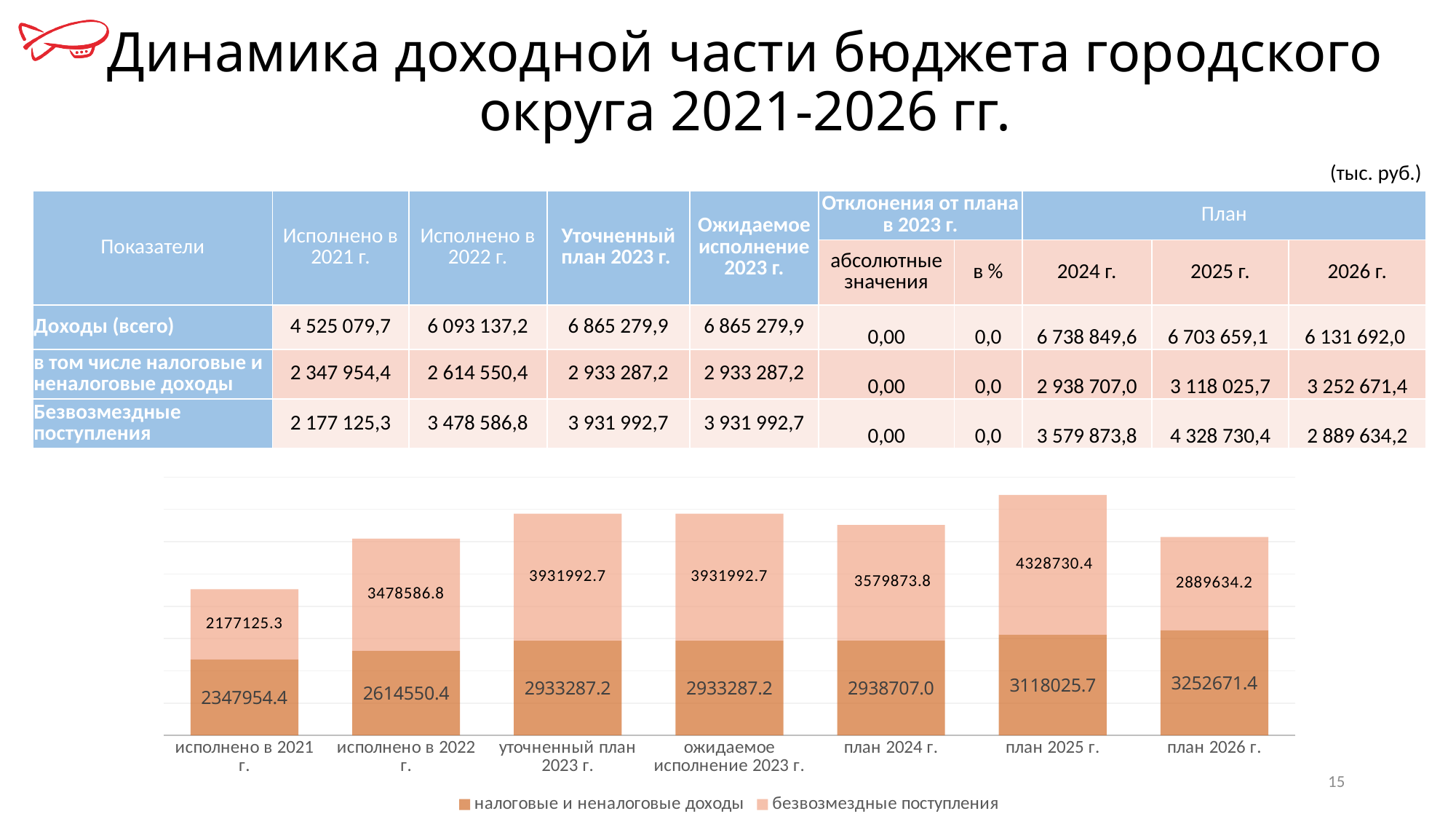
How many series does the chart legend list? 2 What is the value of налоговые и неналоговые доходы for план 2026 г. in the chart? 3252671.4 What is the difference between налоговые и неналоговые доходы for план 2026 г. and for исполнено в 2021 г. in the chart? 904717.0 Which is larger in the chart: безвозмездные поступления for план 2025 г. or for план 2026 г.? план 2025 г. What is the difference between безвозмездные поступления for план 2025 г. and for план 2024 г. in the chart? 748856.6 Which category has the lowest value of налоговые и неналоговые доходы in the chart? исполнено в 2021 г. Do the values of налоговые и неналоговые доходы rise or fall from исполнено в 2021 г. to план 2026 г. in the chart? rise Which category has the highest value of безвозмездные поступления in the chart? план 2025 г. What type of chart is shown on the slide? stacked bar chart What is the value of безвозмездные поступления for исполнено в 2022 г. in the chart? 3478586.8 What is the total of the stacked bar for план 2024 г. in the chart? 6518580.8 How many categories are shown along the x axis of the chart? 7